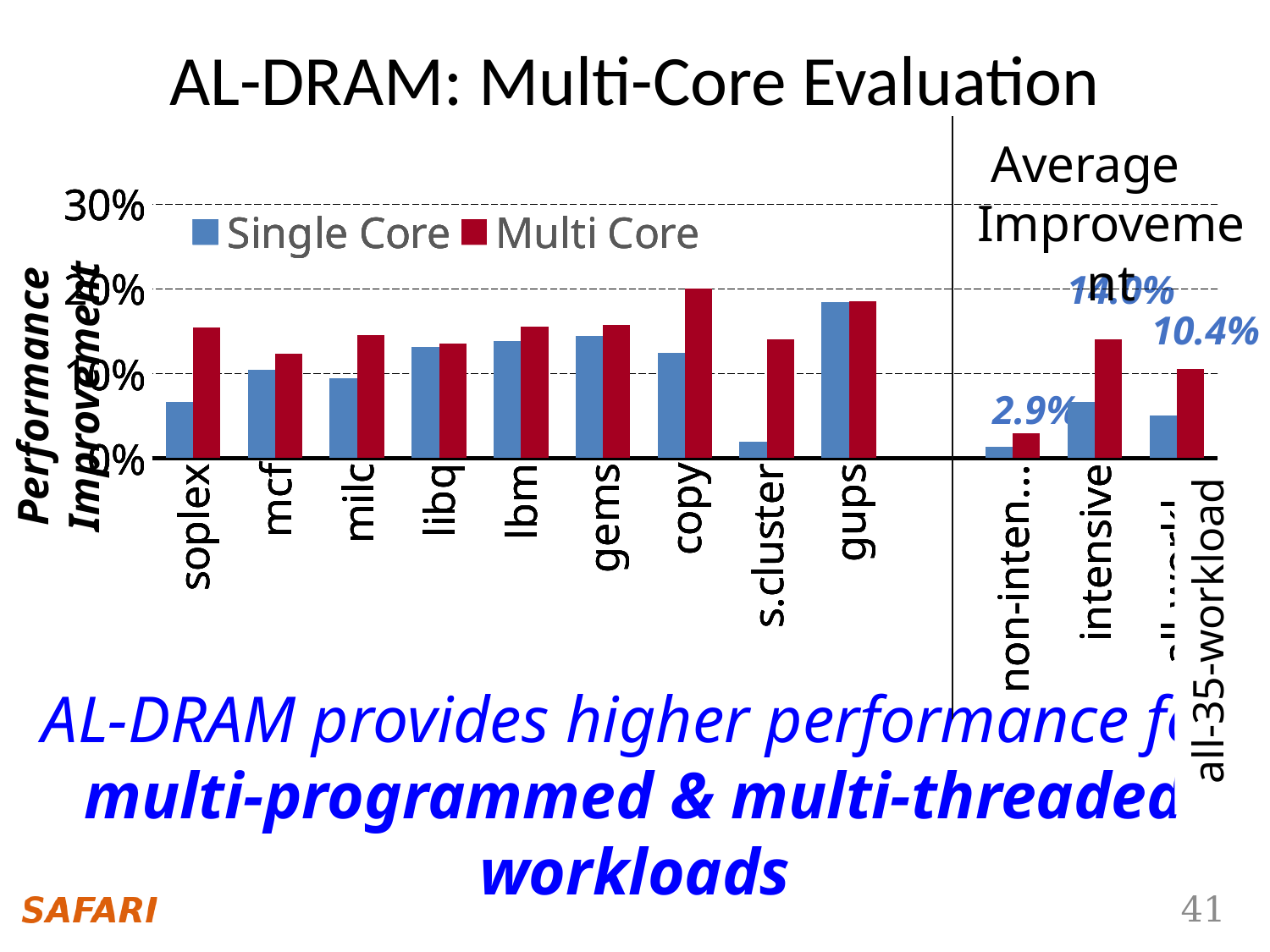
What is the Multi Core performance improvement labelled for all-35-workload? 10.4% What is the Multi Core performance improvement labelled for the non-intensive workload? 2.9% Is the Multi Core value for copy greater or less than 10%? greater Among the nine individual benchmarks to the left of the divider, which has the lowest Single Core bar? s.cluster How many series does the legend list? 2 For Single Core, which is larger: soplex or mcf? mcf Among the nine individual benchmarks to the left of the divider, which has the highest Multi Core bar? copy How many individual benchmark categories are plotted to the left of the vertical divider line? 9 Is the Single Core value for s.cluster greater or less than 10%? less What kind of chart is shown on the slide? bar chart What are the two series named in the legend? Single Core and Multi Core For soplex, which is larger: the Single Core or the Multi Core bar? Multi Core